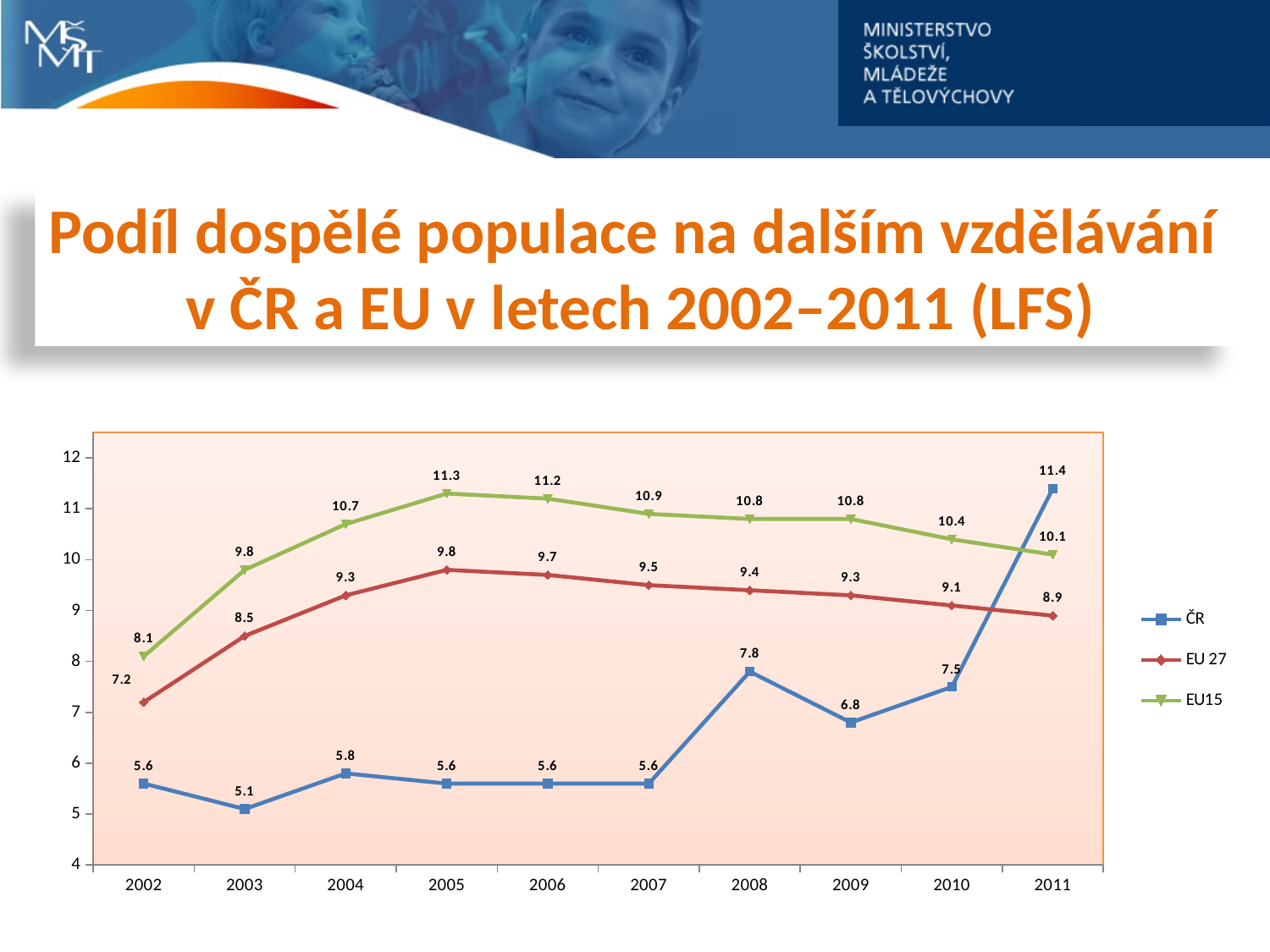
In which year is the ČR value lowest? 2003 Which is larger in 2011, the ČR value or the EU 27 value? ČR What is the value for ČR in 2011? 11.4 What is the value for EU15 in 2002? 8.1 What is the difference between the EU15 and ČR values in 2002? 2.5 Which series is drawn in green? EU15 How many series does the legend list? 3 In which year is the EU15 value highest? 2005 What kind of chart is shown on the slide? line chart Does the EU 27 value rise or fall from 2005 to 2011? fall What is the value for EU 27 in 2005? 9.8 How many years are shown on the x axis? 10